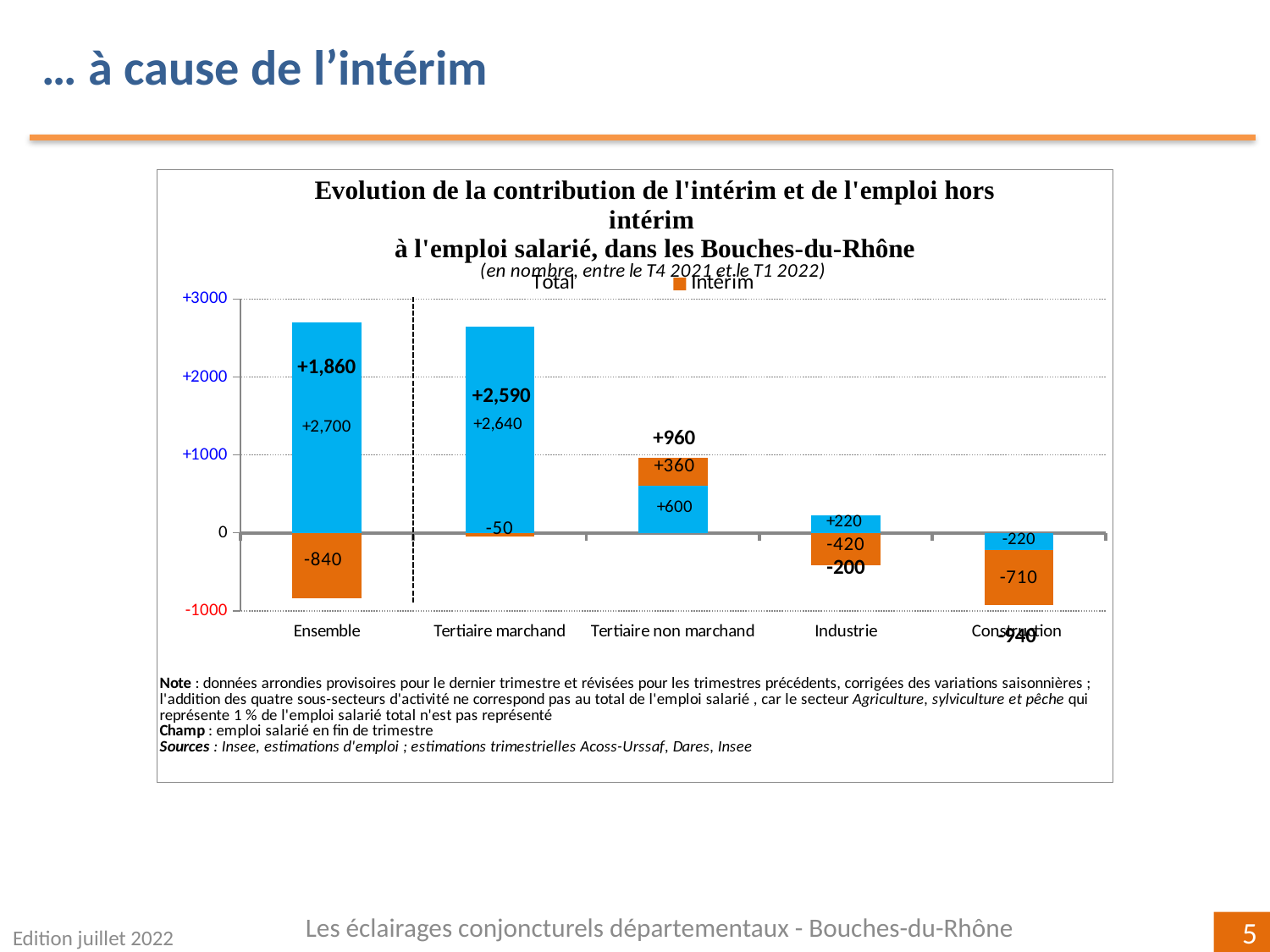
What is the bold total value shown for Tertiaire marchand? +2,590 What is the Intérim (orange) value for Ensemble? -840 What is the Intérim (orange) value for Tertiaire non marchand? +360 Which is larger, the Intérim value for Tertiaire non marchand or for Industrie? Tertiaire non marchand What is the blue segment value for Construction? -220 What is the Intérim (orange) value for Industrie? -420 What kind of chart is shown on the slide? Bar chart What is the difference between the Intérim values for Construction (-710) and Industrie (-420)? 290 Which series does the orange colour represent in the legend? Intérim Which category has the lowest bold total value? Construction How many categories are shown on the x axis? 5 Which category has the highest bold total value? Tertiaire marchand